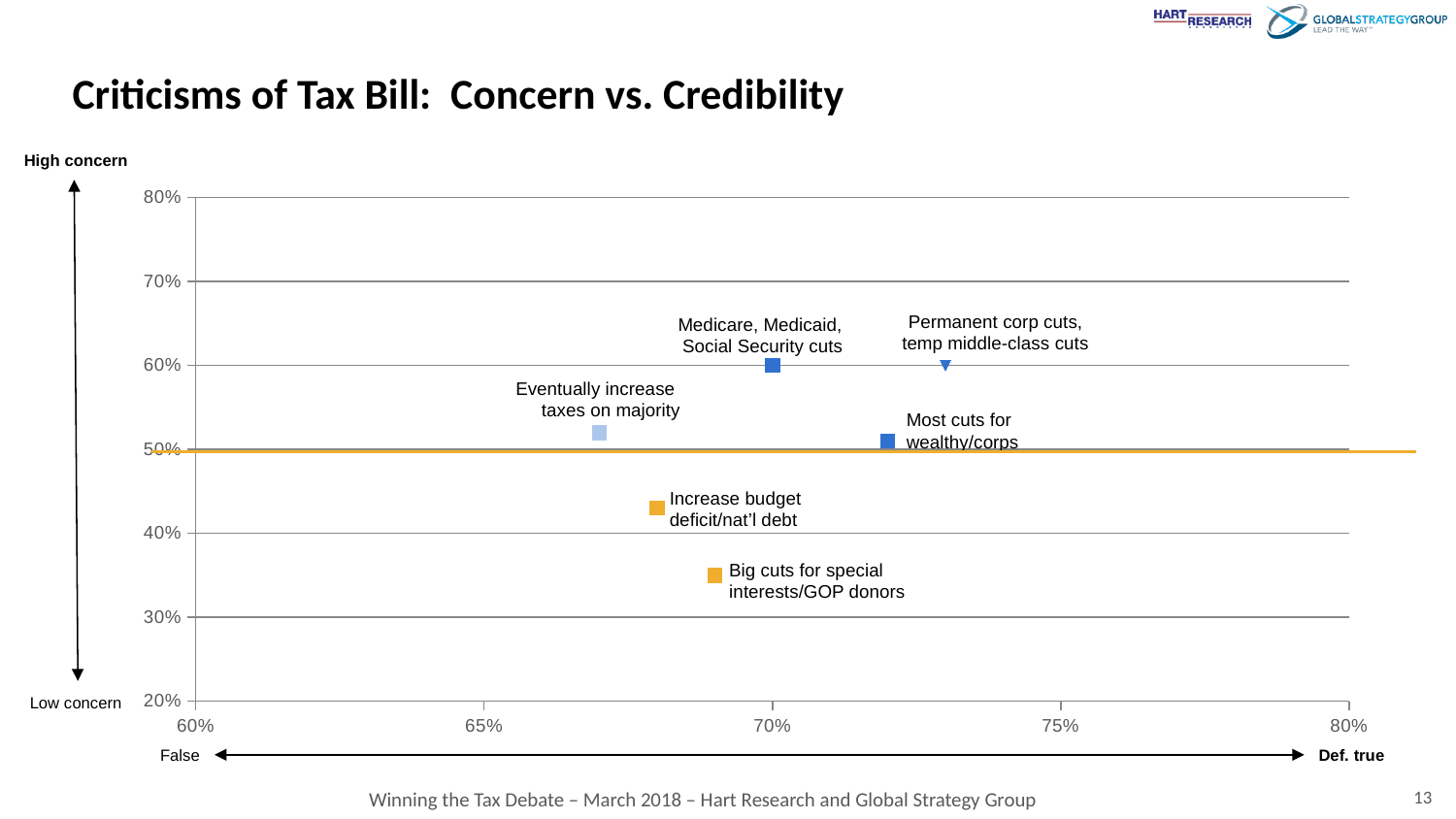
Is the concern value for "Medicare, Medicaid, Social Security cuts" greater or less than 50%? greater What label appears at the right end of the horizontal axis? Def. true Which has the higher concern value: "Increase budget deficit/nat'l debt" or "Big cuts for special interests/GOP donors"? Increase budget deficit/nat'l debt Is the credibility (horizontal) value for "Permanent corp cuts, temp middle-class cuts" greater or less than 70%? greater Which criticism has the lowest concern value on the chart? Big cuts for special interests/GOP donors Which has the higher concern value: "Medicare, Medicaid, Social Security cuts" or "Eventually increase taxes on majority"? Medicare, Medicaid, Social Security cuts Is the credibility (horizontal) value for "Eventually increase taxes on majority" greater or less than 70%? less What is the title of the chart on the slide? Criticisms of Tax Bill: Concern vs. Credibility What kind of chart is shown on the slide? scatter chart How many criticisms are plotted as points on the chart? 6